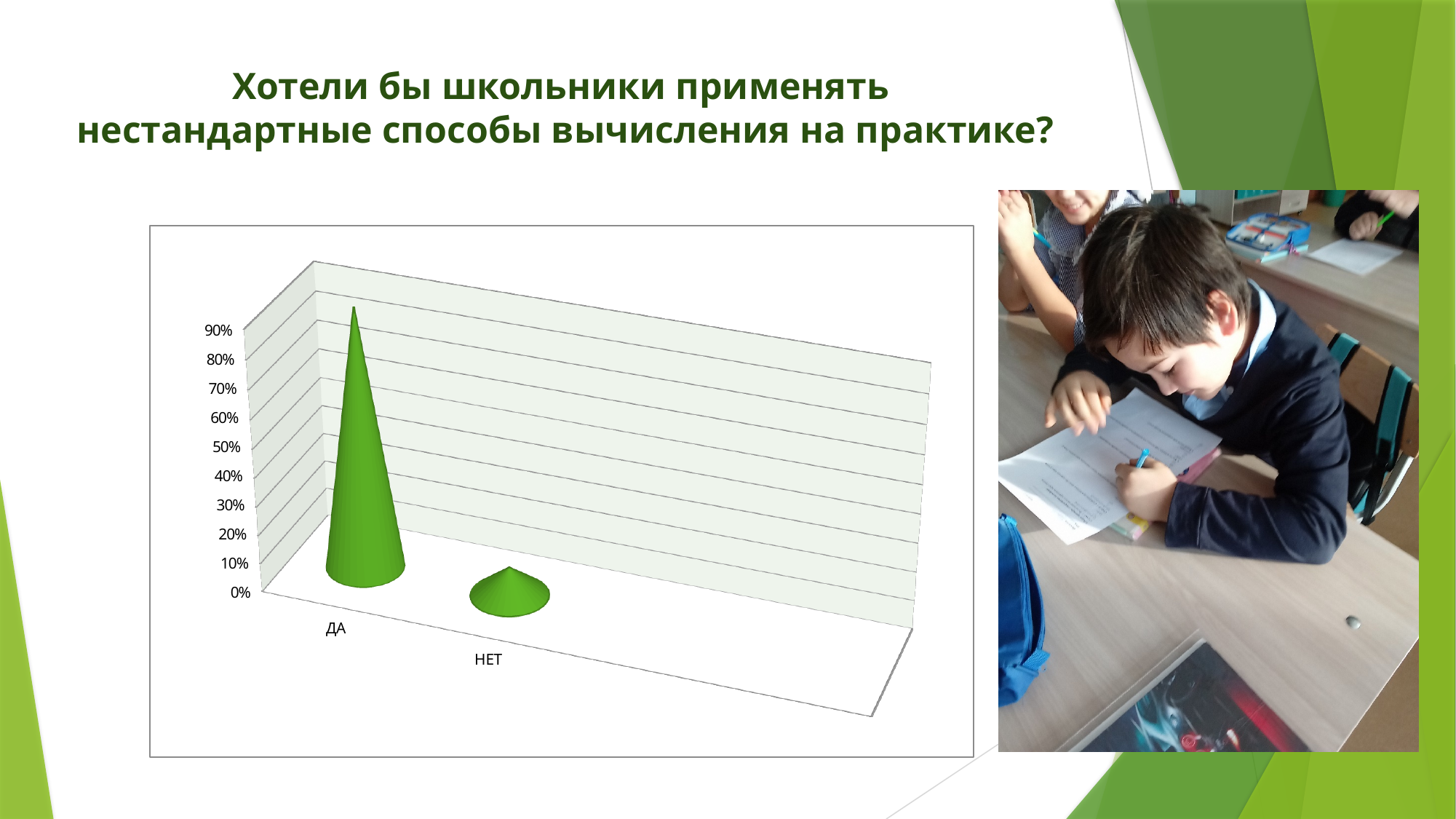
What kind of chart is shown on the slide? bar chart Do the values rise or fall going from ДА to НЕТ along the x axis? fall How many categories are plotted on the chart? 2 Is the value for НЕТ greater or less than 50%? less Which category has the highest value on the chart? ДА Is the value for ДА greater or less than 50%? greater What is the highest percentage tick shown on the vertical axis of the chart? 90% What are the two category labels on the x axis of the chart? ДА and НЕТ Which is larger, the value for ДА or the value for НЕТ? ДА Is the value for НЕТ greater or less than 30%? less Which category has the lowest value on the chart? НЕТ